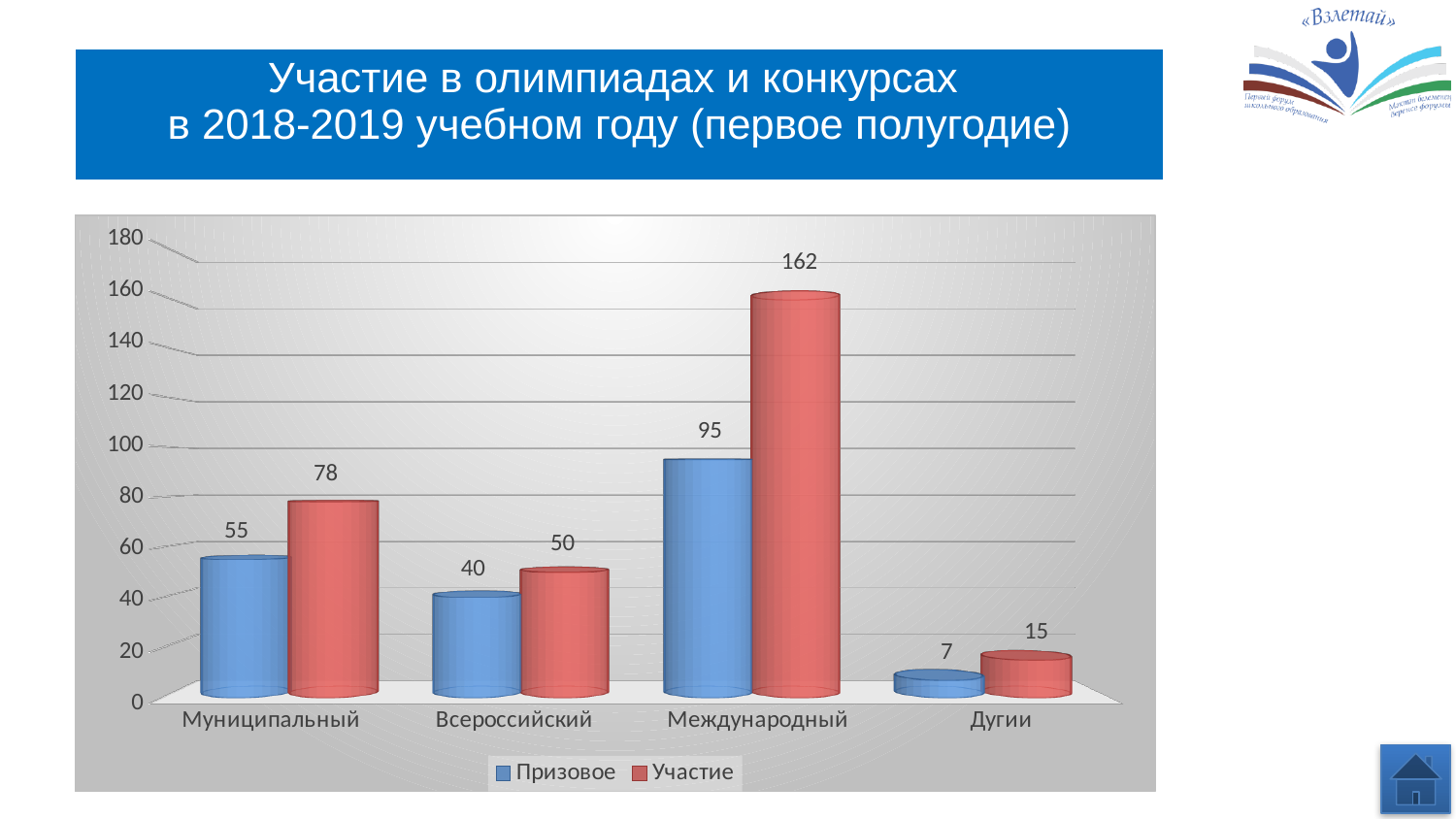
How many categories are shown on the x axis? 4 Which category has the highest Участие value? Международный What is the value of Участие for Международный? 162 How many series does the legend list? 2 Which is larger: Призовое for Всероссийский or Призовое for Муниципальный? Призовое for Муниципальный What is the value of Призовое for Муниципальный? 55 Which series is shown in red? Участие What is the difference between Участие and Призовое for Международный? 67 What kind of chart is shown on the slide? Bar chart What is the difference between Участие for Муниципальный and Участие for Всероссийский? 28 Which category has the lowest Призовое value? Дугии What is the value of Участие for Дугии? 15